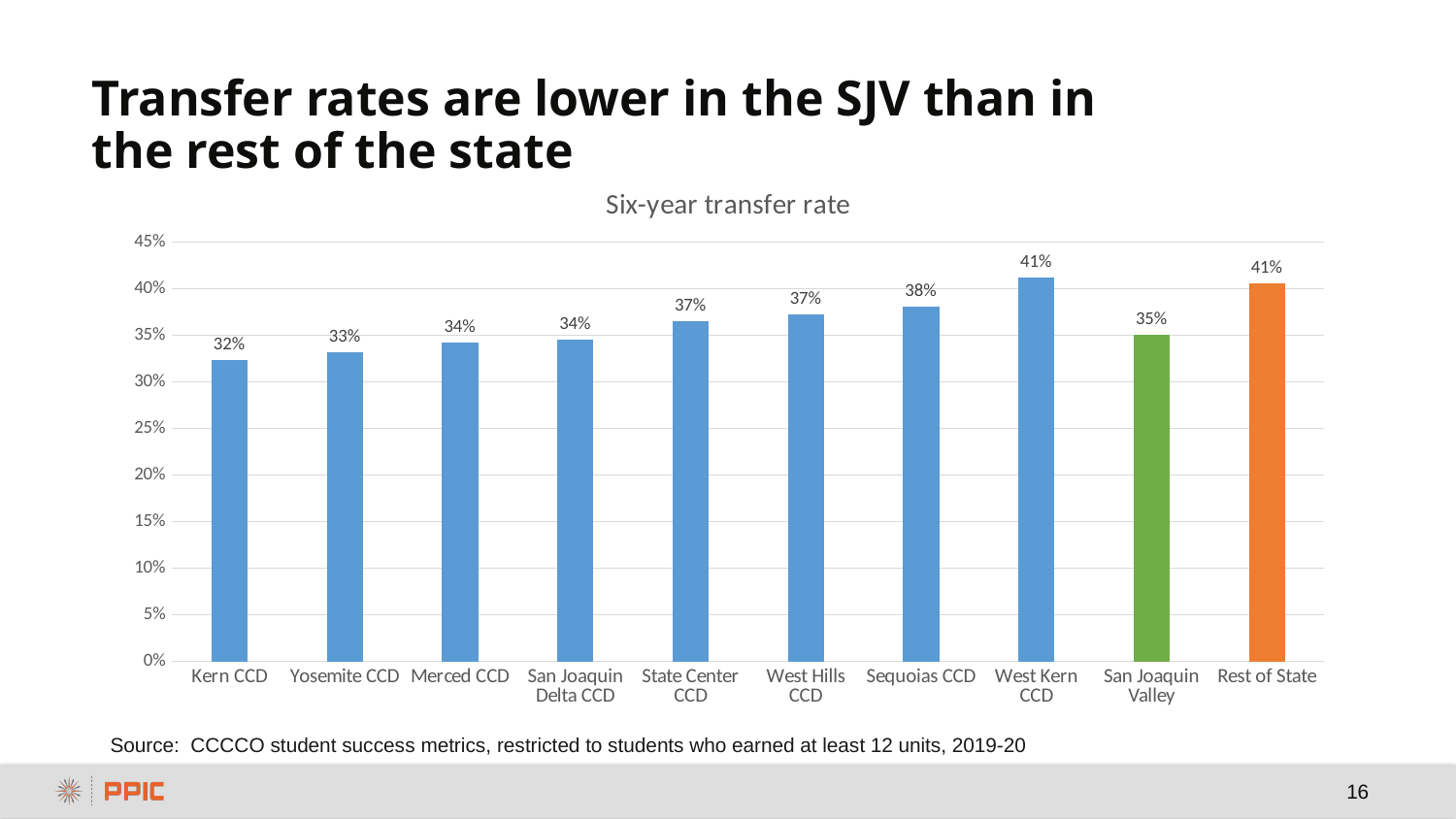
Which category has the lowest six-year transfer rate? Kern CCD Is the six-year transfer rate for Yosemite CCD greater or less than 35%? less What is the six-year transfer rate for Kern CCD? 32% What is the title of the chart? Six-year transfer rate What is the six-year transfer rate for San Joaquin Valley? 35% What is the six-year transfer rate for Sequoias CCD? 38% What kind of chart is shown on the slide? bar chart How many categories are shown on the x axis of the chart? 10 What is the difference between the six-year transfer rate for the Rest of State and for San Joaquin Valley? 6% Which has a higher six-year transfer rate, Sequoias CCD or Merced CCD? Sequoias CCD What is the six-year transfer rate for the Rest of State? 41% What is the difference between the six-year transfer rate for West Kern CCD and Kern CCD? 9%